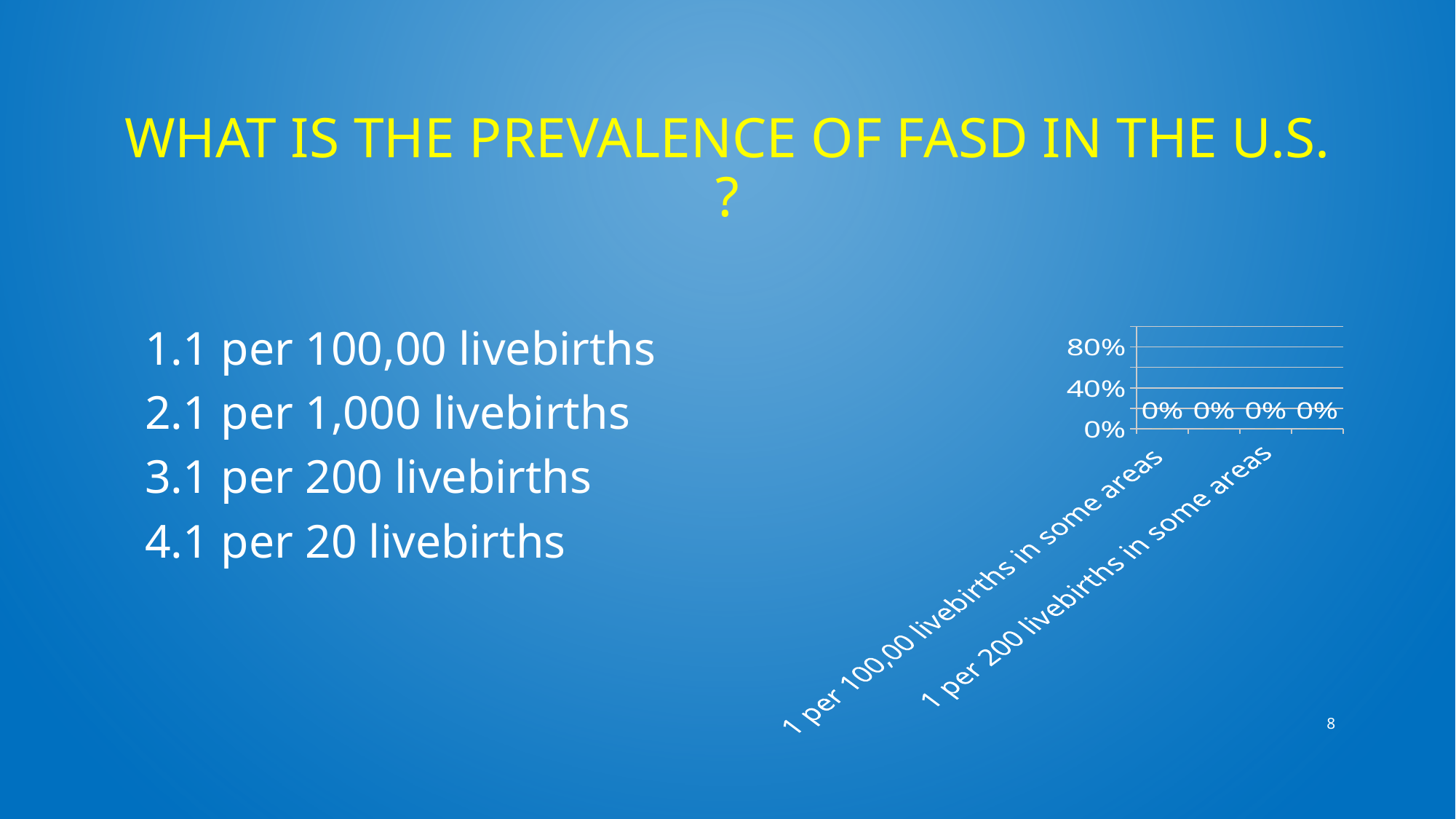
What value is shown for "1 per 100,00 livebirths in some areas" in the chart? 0% What value is shown for "1 per 200 livebirths in some areas" in the chart? 0% Is the value for "1 per 100,00 livebirths in some areas" greater or less than 80%? less What is the highest value labelled on the chart's vertical axis? 80% What is the title of the slide containing the chart? WHAT IS THE PREVALENCE OF FASD IN THE U.S.? Do all the data labels on the chart show the same value? Yes, 0% How many data labels are printed on the chart? 4 What is the difference between the values for "1 per 100,00 livebirths in some areas" and "1 per 200 livebirths in some areas"? 0% Is the value for "1 per 200 livebirths in some areas" greater or less than 40%? less